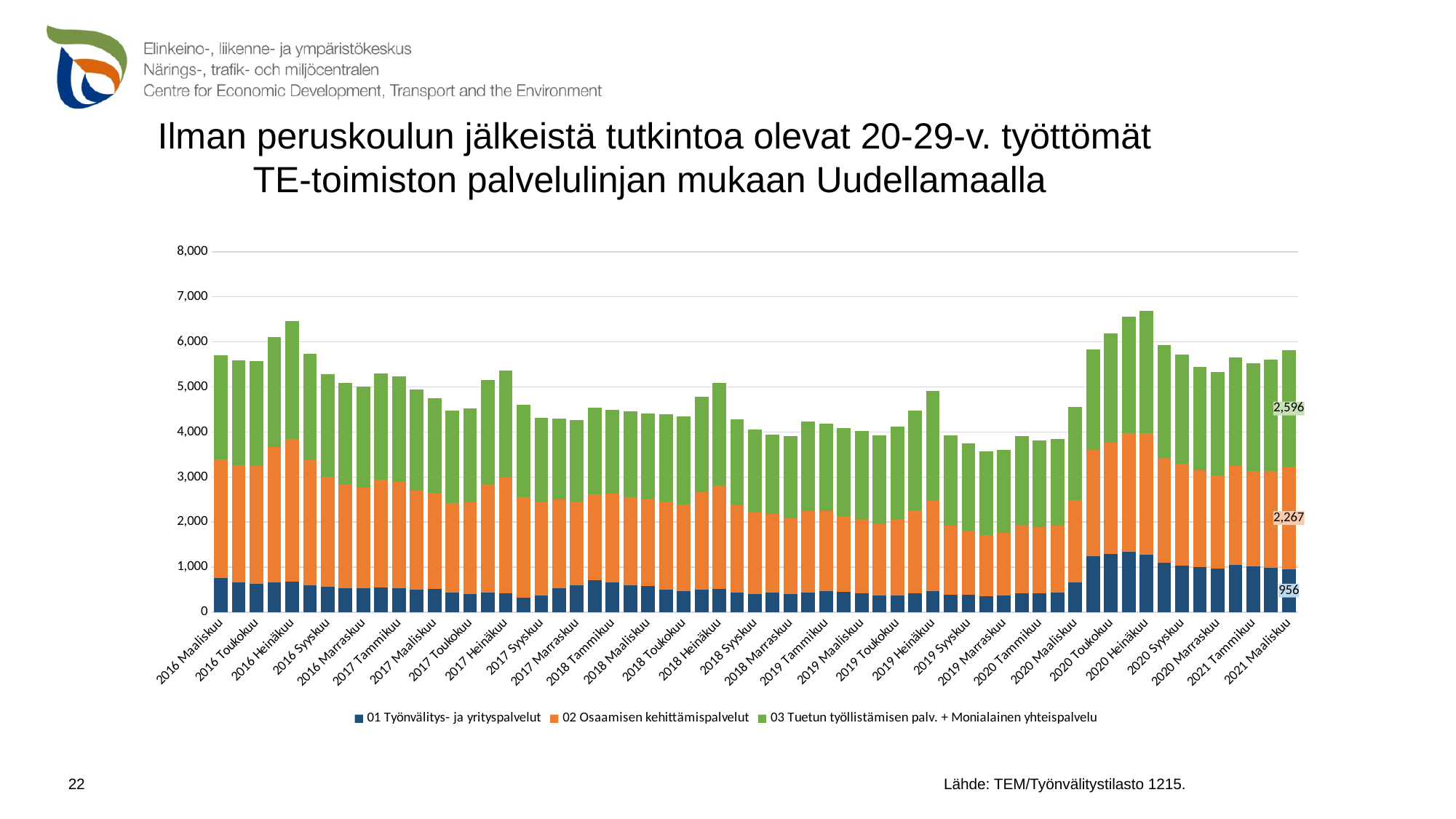
What is the total of the stacked bar for 2021 Maaliskuu? 5,819 What is the value of the 01 Työnvälitys- ja yrityspalvelut series for 2021 Maaliskuu? 956 What is the value of the 02 Osaamisen kehittämispalvelut series for 2021 Maaliskuu? 2,267 Which has a larger total, 2020 Heinäkuu or 2016 Maaliskuu? 2020 Heinäkuu Is the total value for 2019 Marraskuu greater or less than 4,000? less How many series does the legend list? 3 Which series is shown in green in the legend? 03 Tuetun työllistämisen palv. + Monialainen yhteispalvelu Is the total value for 2020 Heinäkuu greater or less than 6,000? greater Do the total values generally rise or fall from 2016 Heinäkuu to 2019 Marraskuu? fall What is the difference between the 03 Tuetun työllistämisen palv. + Monialainen yhteispalvelu value and the 02 Osaamisen kehittämispalvelut value for 2021 Maaliskuu? 329 What is the value of the 03 Tuetun työllistämisen palv. + Monialainen yhteispalvelu series for 2021 Maaliskuu? 2,596 What kind of chart is shown on the slide? Stacked bar chart